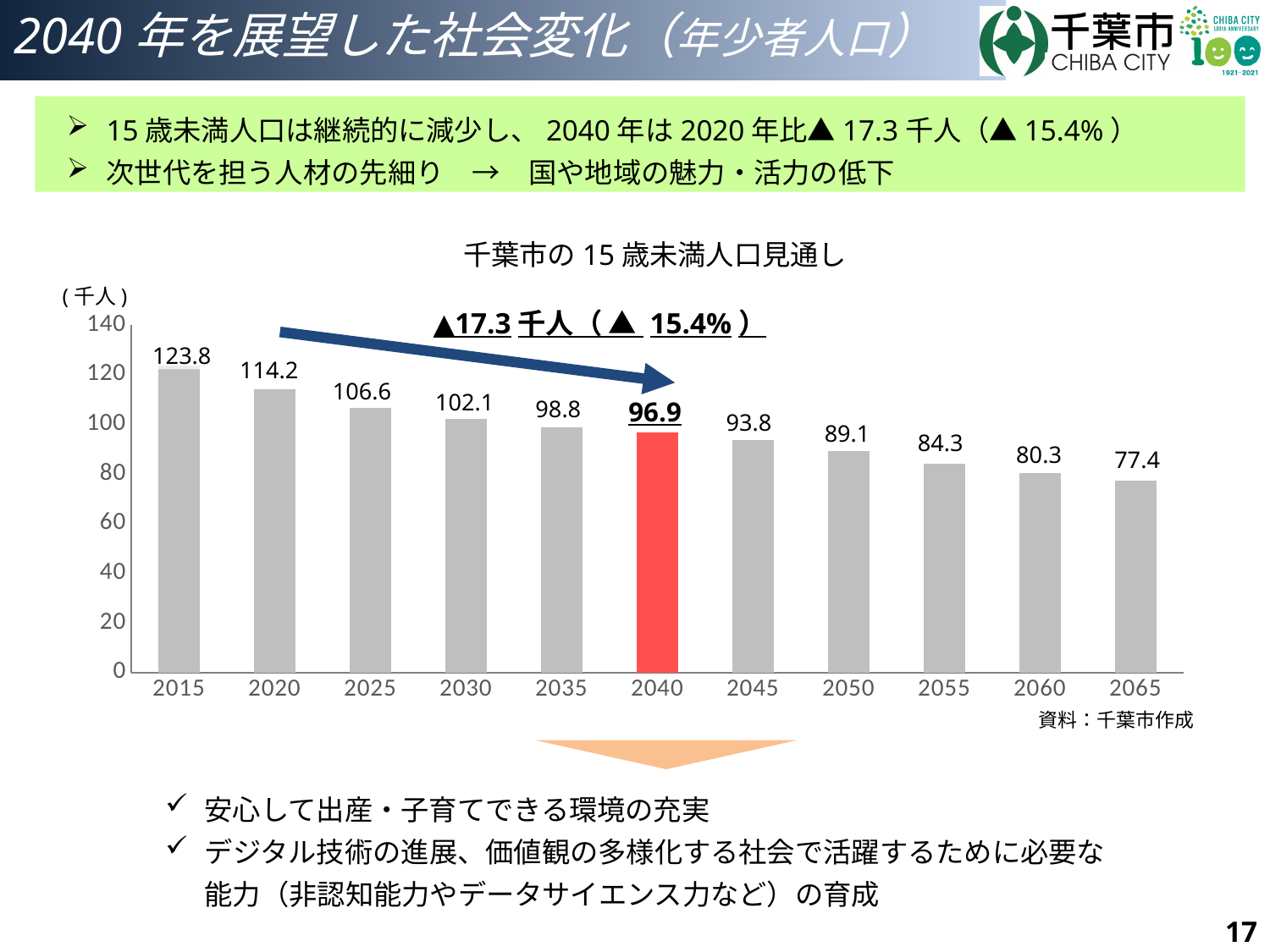
Do the values rise or fall from 2015 to 2065? fall How many years are shown on the x axis? 11 What is the value for 2040? 96.9 What is the value for 2065? 77.4 What is the difference between the values for 2020 and 2040? 17.3 Which year's bar is highlighted in red? 2040 Is the value for 2055 greater or less than 100? less Which year has the lowest value? 2065 What kind of chart is this? bar chart Which is larger, the value for 2030 or the value for 2050? 2030 What is the value for 2015? 123.8 Which year has the highest value? 2015